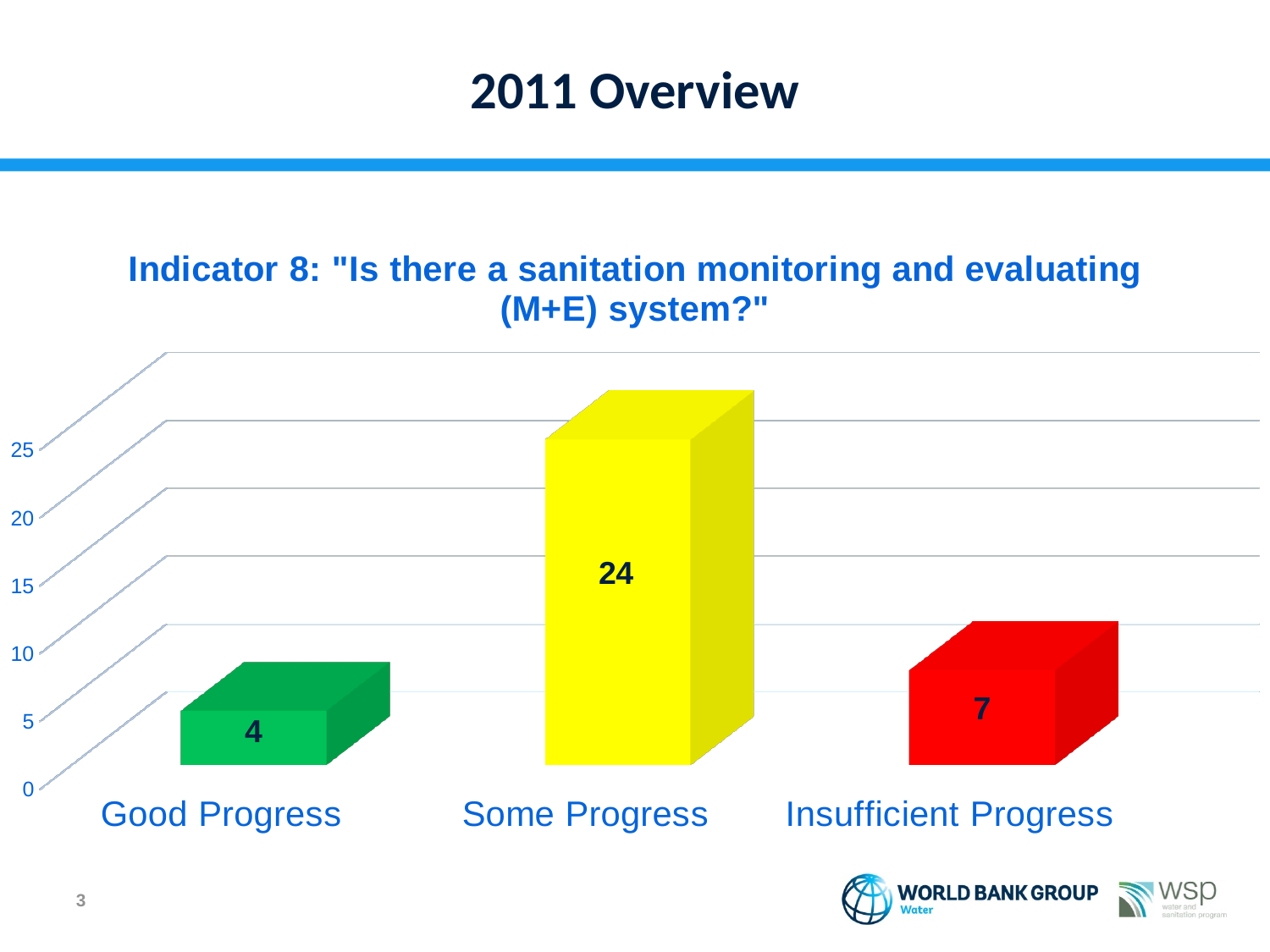
What is the difference between the values for Some Progress and Insufficient Progress? 17 Is the value for Some Progress greater or less than 20? greater What kind of chart is shown on the slide? bar chart Which is larger, the value for Good Progress or the value for Insufficient Progress? Insufficient Progress What is the difference between the values for Insufficient Progress and Good Progress? 3 What is the value for Some Progress? 24 Which category has the lowest value? Good Progress Which category has the highest value? Some Progress How many categories are shown in the chart? 3 What colour is the bar for Some Progress? yellow What is the value for Good Progress? 4 What is the value for Insufficient Progress? 7